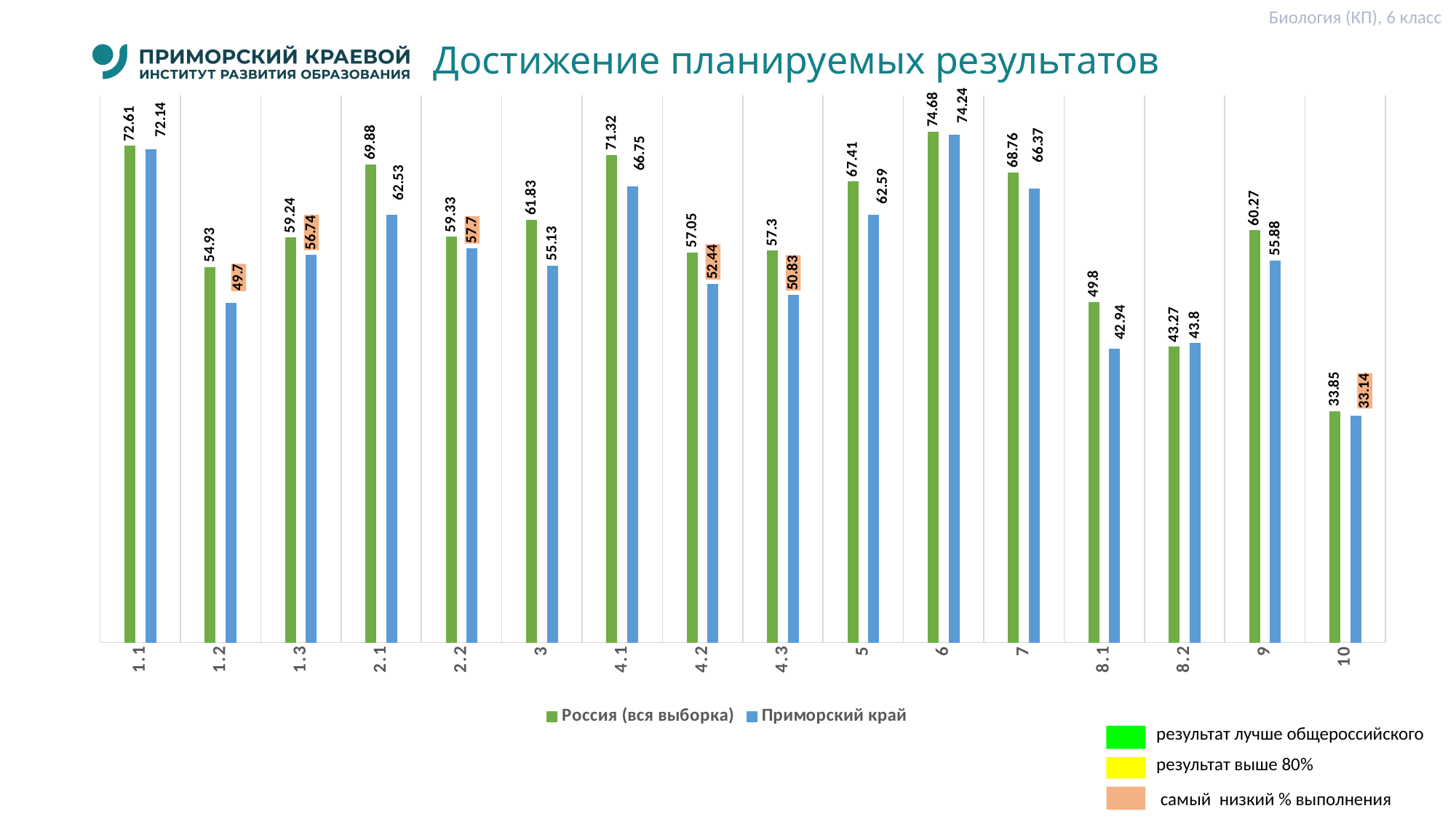
What is the difference between the Россия (вся выборка) and Приморский край values for category 2.1? 7.35 Which category has the lowest value for Приморский край? 10 Which category has the highest value for Россия (вся выборка)? 6 What is the value for Приморский край for category 1.2? 49.7 What is the title of the chart? Достижение планируемых результатов What is the value for Приморский край for category 6? 74.24 How many categories are shown on the x axis? 16 For category 8.2, which series has the larger value: Россия (вся выборка) or Приморский край? Приморский край What kind of chart is shown on the slide? bar chart Which colour represents the series Приморский край? blue How many series does the legend list? 2 What is the value for Россия (вся выборка) for category 8.1? 49.8